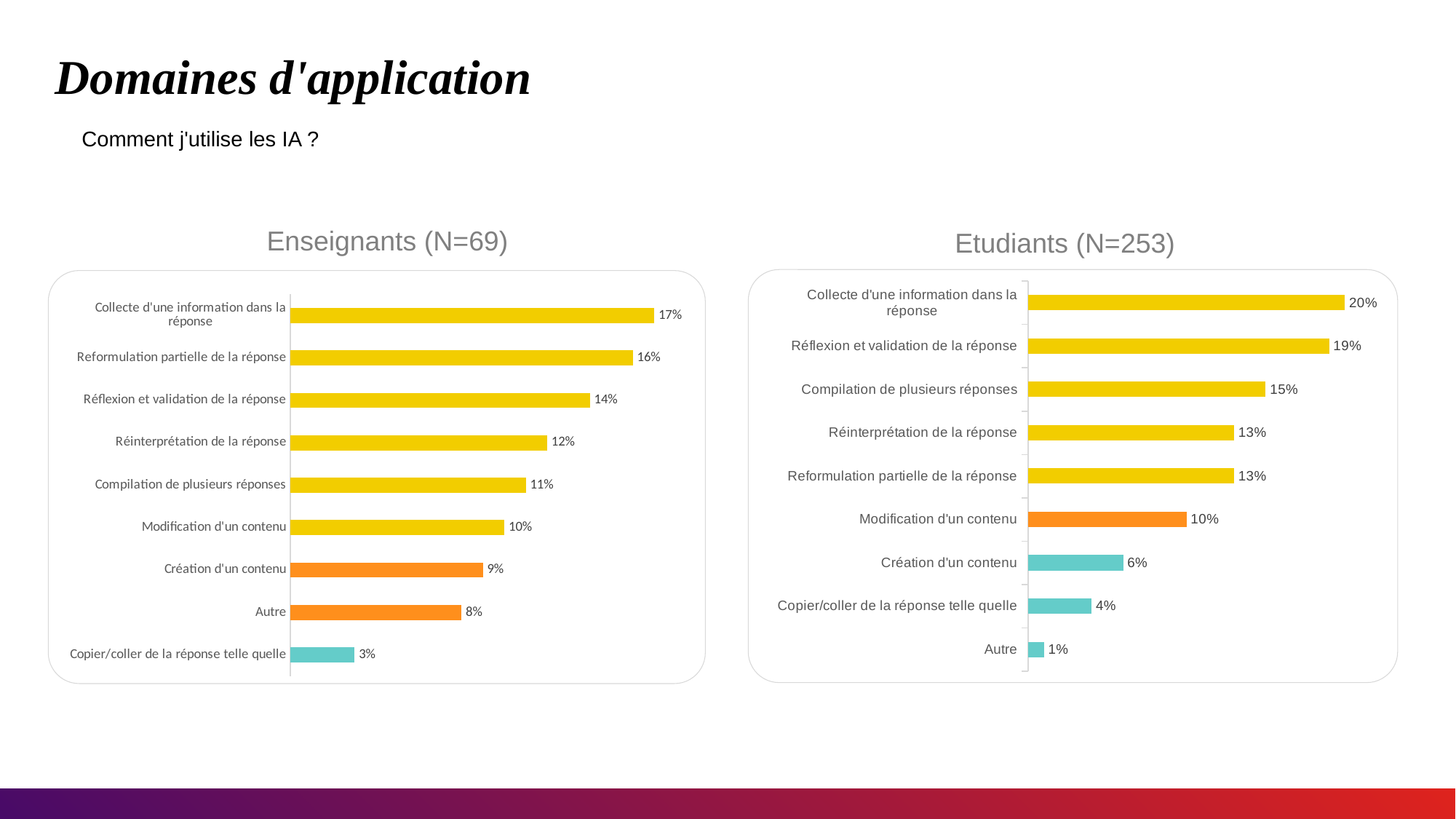
In the Enseignants (N=69) chart, which is larger: Autre or Création d'un contenu? Création d'un contenu What kind of chart is the Etudiants (N=253) chart? Bar chart In the Enseignants (N=69) chart, what is the value for Autre? 8% In the Etudiants (N=253) chart, which is larger: Compilation de plusieurs réponses or Modification d'un contenu? Compilation de plusieurs réponses In the Enseignants (N=69) chart, what is the difference between Reformulation partielle de la réponse and Copier/coller de la réponse telle quelle? 13% How many categories are shown in the Etudiants (N=253) chart? 9 How many categories are shown in the Enseignants (N=69) chart? 9 In the Enseignants (N=69) chart, what is the value for Collecte d'une information dans la réponse? 17% In the Etudiants (N=253) chart, which category has the lowest value? Autre In the Etudiants (N=253) chart, what is the value for Réflexion et validation de la réponse? 19% In the Etudiants (N=253) chart, what is the difference between Collecte d'une information dans la réponse and Création d'un contenu? 14% In the Enseignants (N=69) chart, which category has the highest value? Collecte d'une information dans la réponse